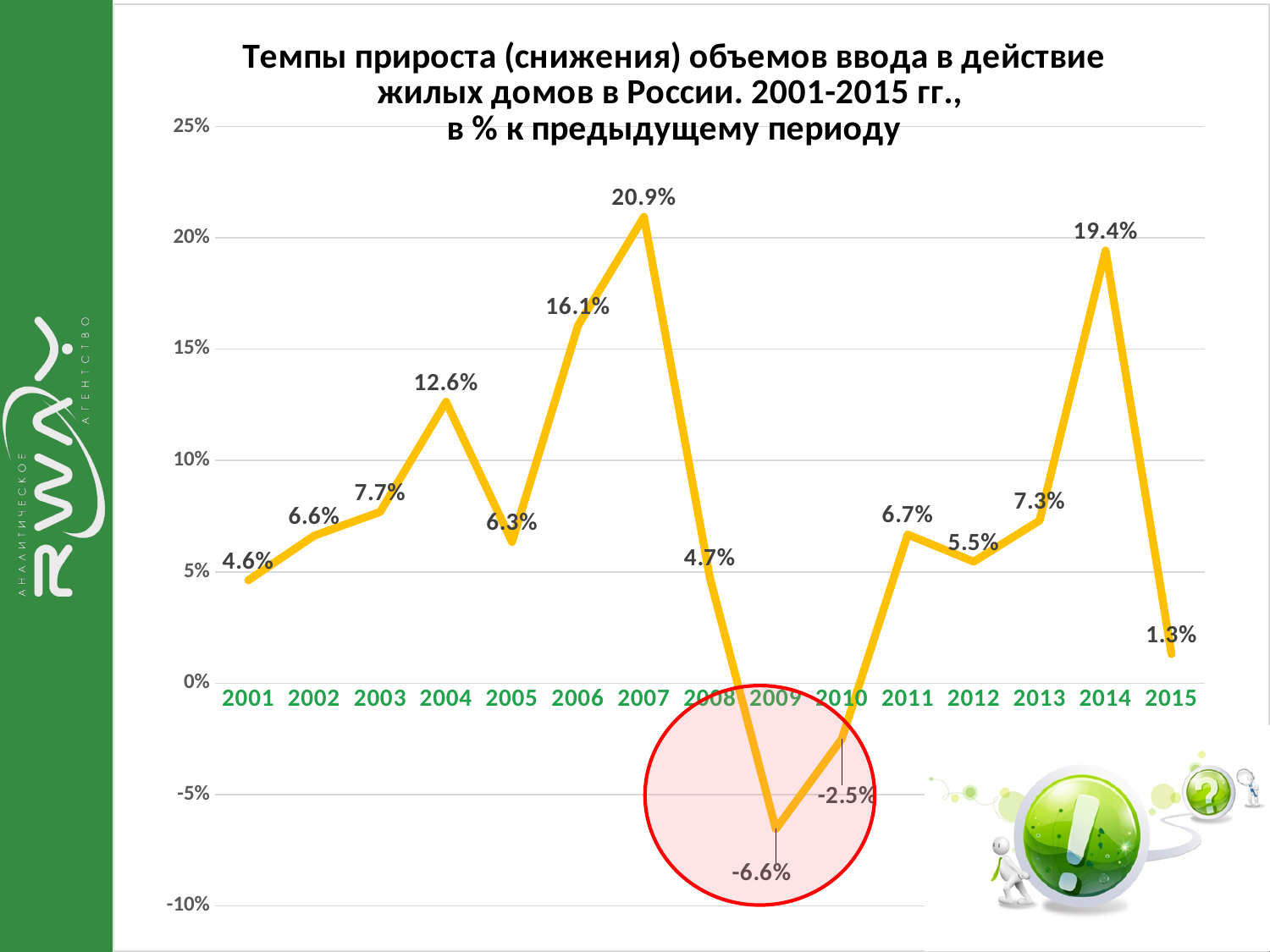
What is the value for 2007? 20.9% How many years have a negative value? 2 What is the difference between the values for 2007 and 2014? 1.5% What is the value for 2004? 12.6% Which is larger, the value for 2006 or the value for 2004? 2006 Which year has the highest value? 2007 Which year has the lowest value? 2009 What type of chart is shown on the slide? Line chart How many years are plotted on the x axis? 15 Does the value rise or fall from 2014 to 2015? Fall What is the value for 2009? -6.6% What is the value for 2015? 1.3%